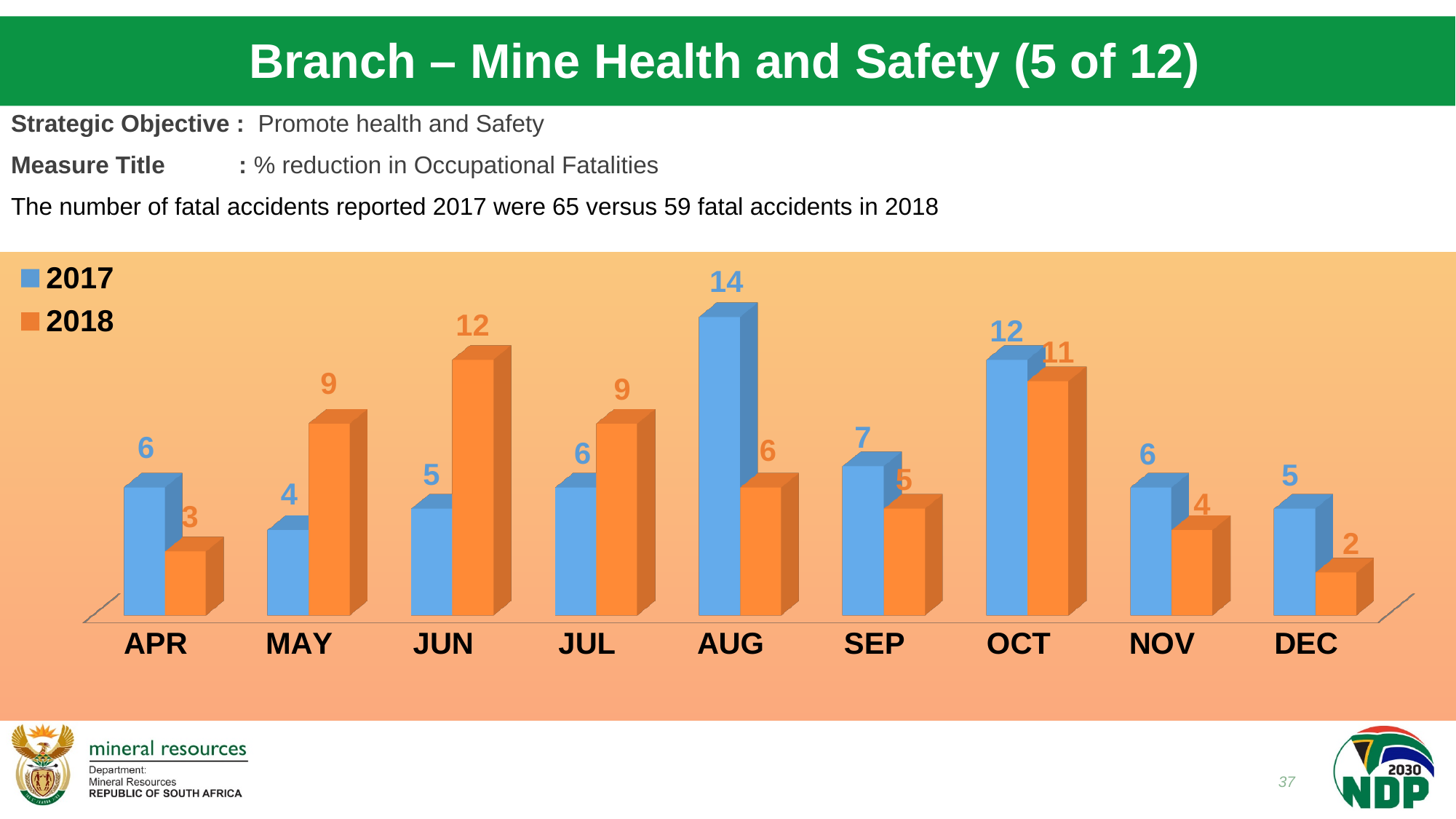
How many series does the legend list? 2 Which month has the lowest value for the 2018 series? DEC Which is larger in MAY, the 2017 value or the 2018 value? 2018 How many months are shown on the x axis of the chart? 9 What is the value for 2018 in DEC? 2 Which is larger in OCT, the 2017 value or the 2018 value? 2017 What is the value for 2018 in JUN? 12 What kind of chart is shown on the slide? Bar chart What is the difference between the 2018 values for JUN and APR? 9 What is the value for 2017 in AUG? 14 What is the difference between the 2017 and 2018 values in AUG? 8 Which month has the highest value for the 2017 series? AUG